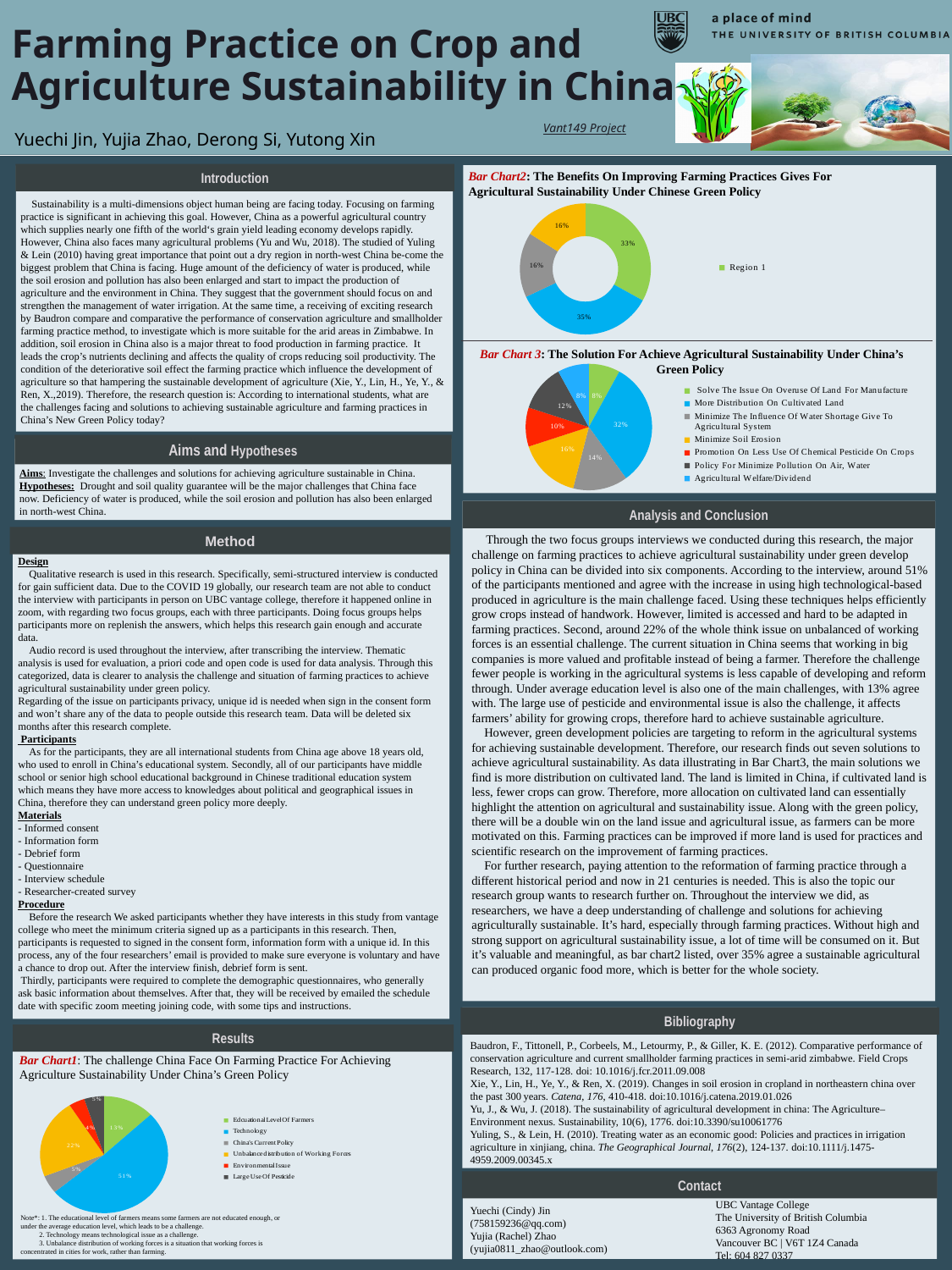
In Bar Chart2, what is the difference between the 35% slice and the 33% slice? 2% In Bar Chart1, what is the value of the largest slice? 51% In Bar Chart 3, which solution has the largest share of the pie? More Distribution On Cultivated Land What kind of chart is Bar Chart1 (the challenge China faces on farming practice)? pie chart In Bar Chart2 (benefits on improving farming practices), what is the value of the largest slice? 35% How many slices does the pie in Bar Chart2 have? 4 How many categories does the legend of Bar Chart 3 list? 7 How many series does the legend of Bar Chart2 list? 1 How many categories does the legend of Bar Chart1 list? 6 In Bar Chart1, what is the value of the smallest slice? 4%